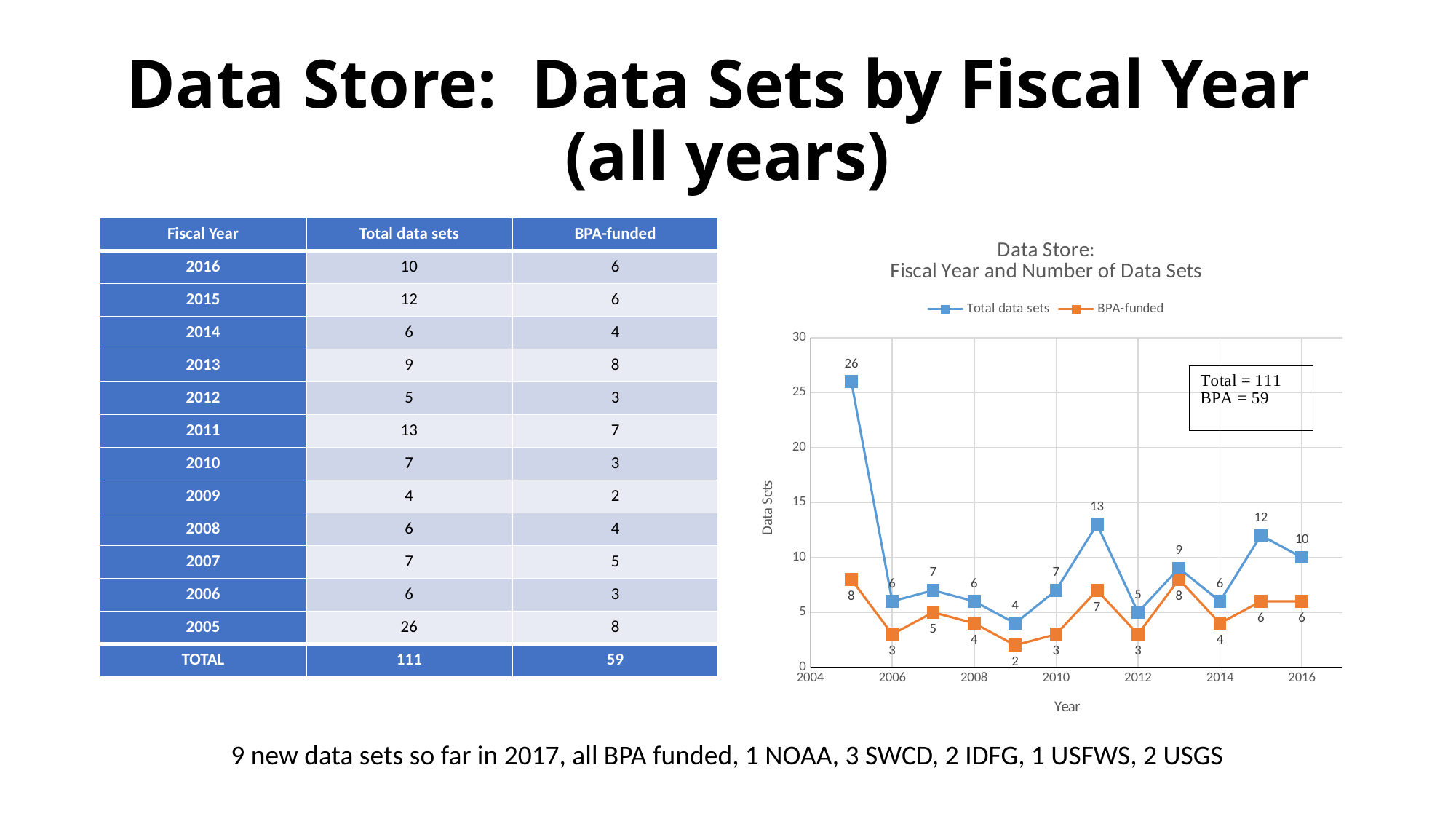
How many series does the chart's legend list? 2 What is the label of the chart's vertical axis? Data Sets What is the title of the chart? Data Store: Fiscal Year and Number of Data Sets What kind of chart is shown on the slide? Line chart Which is larger in the chart: Total data sets in 2011 or Total data sets in 2016? Total data sets in 2011 In which year is Total data sets highest in the chart? 2005 How many years are plotted in the chart? 12 In which year is BPA-funded lowest in the chart? 2009 What is the difference between Total data sets and BPA-funded in 2013? 1 What is the BPA-funded value for 2011 in the chart? 7 What is the value of Total data sets for 2005 in the chart? 26 What is the Total data sets value for 2015 in the chart? 12